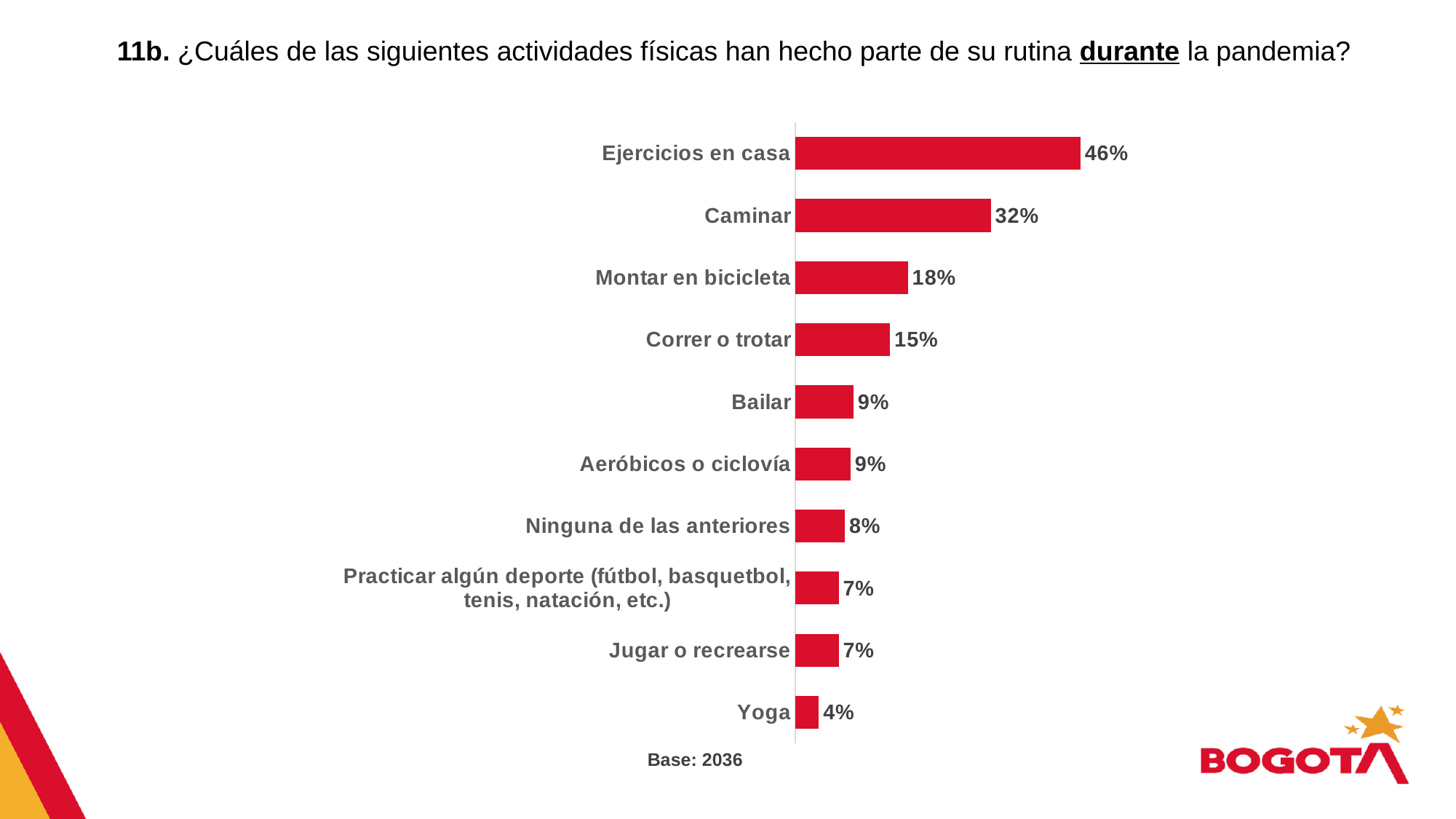
How many categories are shown in the chart? 10 What is the difference in percentage points between Montar en bicicleta and Correr o trotar? 3 What percentage is shown for Yoga? 4% What is the difference in percentage points between Ejercicios en casa and Caminar? 14 Which activity has the highest percentage? Ejercicios en casa Which has a higher percentage, Caminar or Correr o trotar? Caminar What is the base (number of respondents) shown below the chart? 2036 Which activity has the lowest percentage? Yoga What percentage is shown for Ejercicios en casa? 46% What kind of chart is shown on the slide? Bar chart What percentage is shown for Montar en bicicleta? 18% What percentage is shown for Caminar? 32%